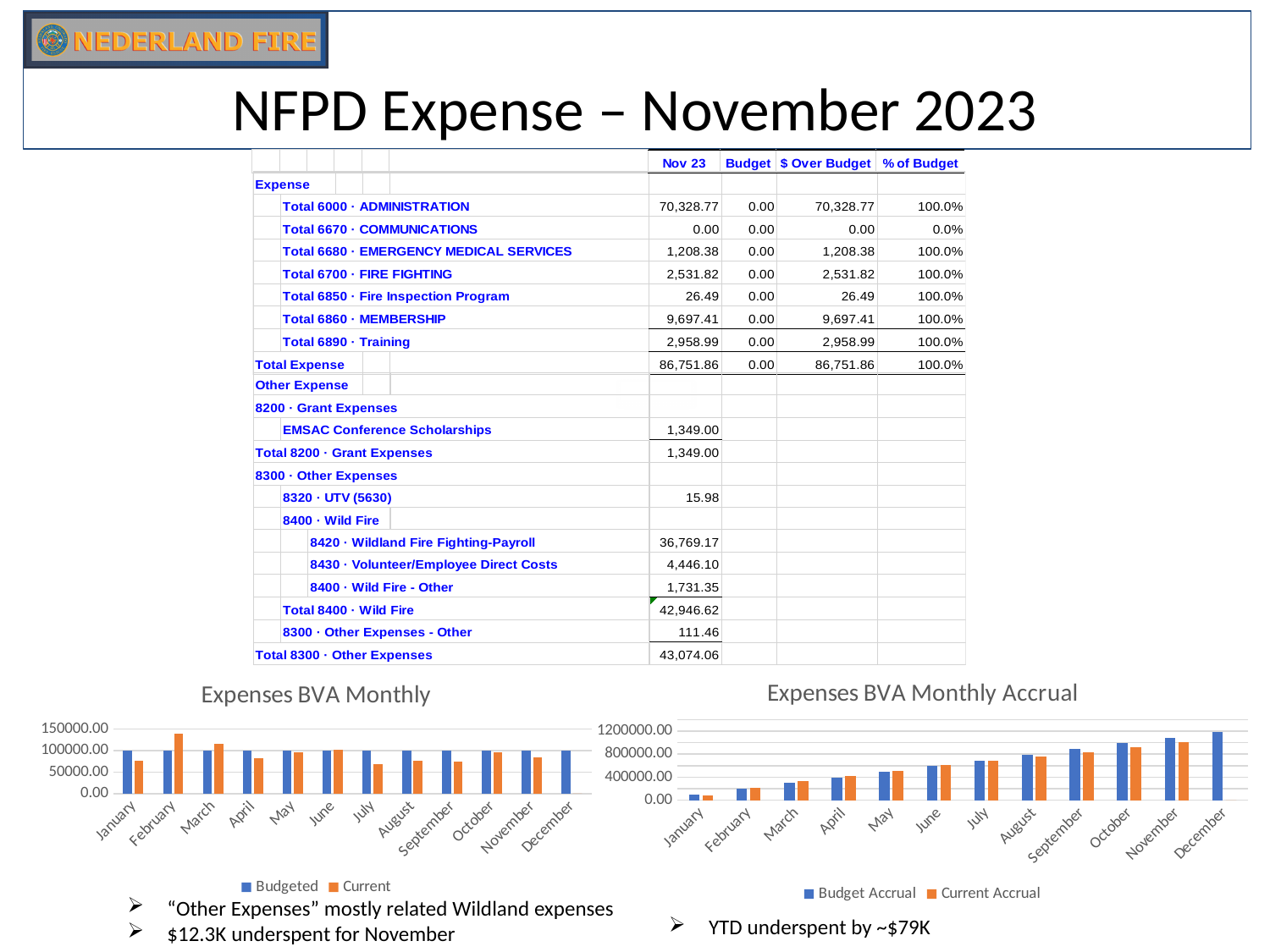
In the "Expenses BVA Monthly" chart, which is larger for February: Budgeted or Current? Current How many series does the legend of the "Expenses BVA Monthly Accrual" chart list? 2 In the "Expenses BVA Monthly Accrual" chart, is the Current Accrual value for January greater or less than 400000? less What are the two legend entries of the "Expenses BVA Monthly Accrual" chart? Budget Accrual and Current Accrual In the "Expenses BVA Monthly Accrual" chart, which month has the highest Budget Accrual value? December In the "Expenses BVA Monthly" chart, which month has the highest Current value? February In the "Expenses BVA Monthly Accrual" chart, is the Budget Accrual value for December greater or less than 800000? greater In the "Expenses BVA Monthly Accrual" chart, do the Budget Accrual values rise or fall from January to December? rise How many months are shown on the x axis of the "Expenses BVA Monthly" chart? 12 What kind of chart is the "Expenses BVA Monthly" chart? bar chart In the "Expenses BVA Monthly" chart, is the Current value for February greater or less than 100000? greater